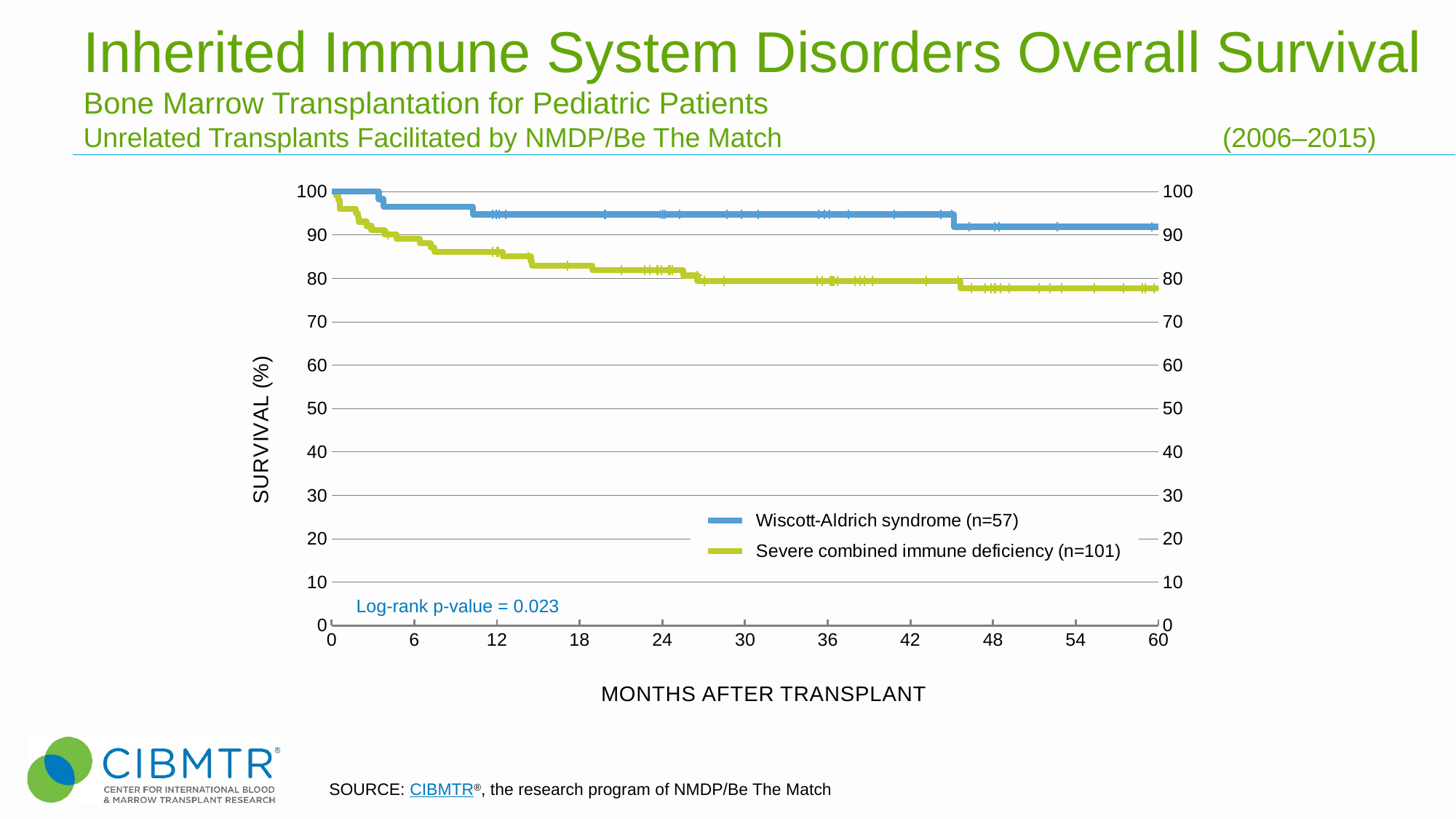
What kind of chart is shown on the slide? line chart Is the survival value for Severe combined immune deficiency at 60 months greater or less than 80? less How many patients (n) are in the Severe combined immune deficiency group according to the legend? 101 How many series does the legend list? 2 Which series has the higher survival at 60 months after transplant? Wiscott-Aldrich syndrome What is the survival value for Wiscott-Aldrich syndrome at 0 months after transplant? 100 Is the survival value for Severe combined immune deficiency at 24 months greater or less than 80? greater Is the survival value for Wiscott-Aldrich syndrome at 60 months greater or less than 90? greater What is the log-rank p-value shown on the chart? 0.023 Do the survival curves rise or fall as months after transplant increase? fall Which series has the lowest survival at 36 months after transplant? Severe combined immune deficiency